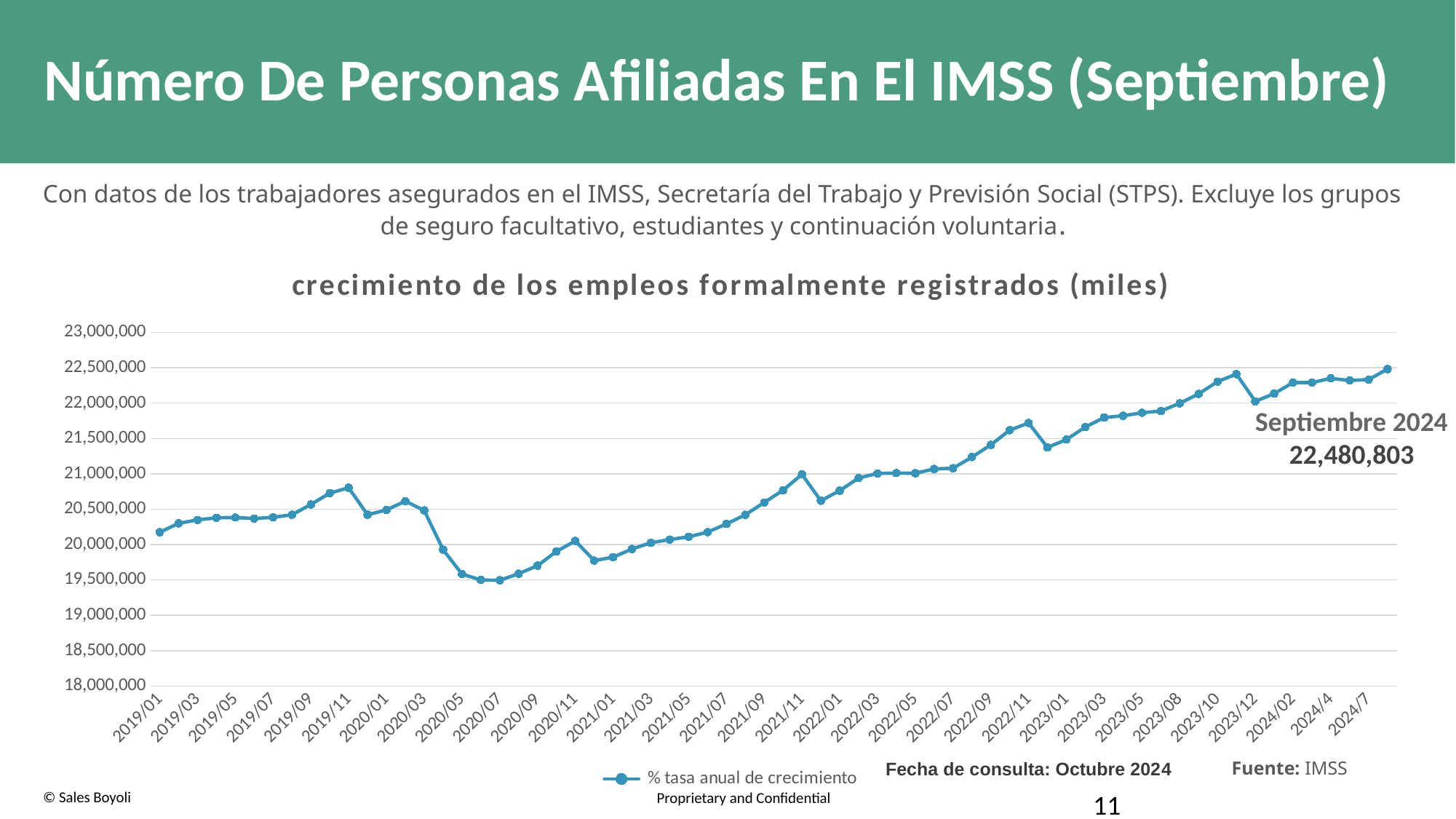
Is the value for 2019/01 greater or less than 20,000,000? greater What is the title of the chart? crecimiento de los empleos formalmente registrados (miles) Is the value for 2021/01 greater or less than 20,000,000? less Overall, do the values rise or fall from 2019/01 to the end of the series? rise How many series does the legend list? 1 Which is larger, the value for 2019/11 or the value for 2020/07? 2019/11 Is the value for 2022/01 greater or less than 21,000,000? less What is the legend entry for the plotted series? % tasa anual de crecimiento What kind of chart is shown on the slide? line chart What is the value shown for Septiembre 2024? 22,480,803 Which point has the highest value on the chart? Septiembre 2024